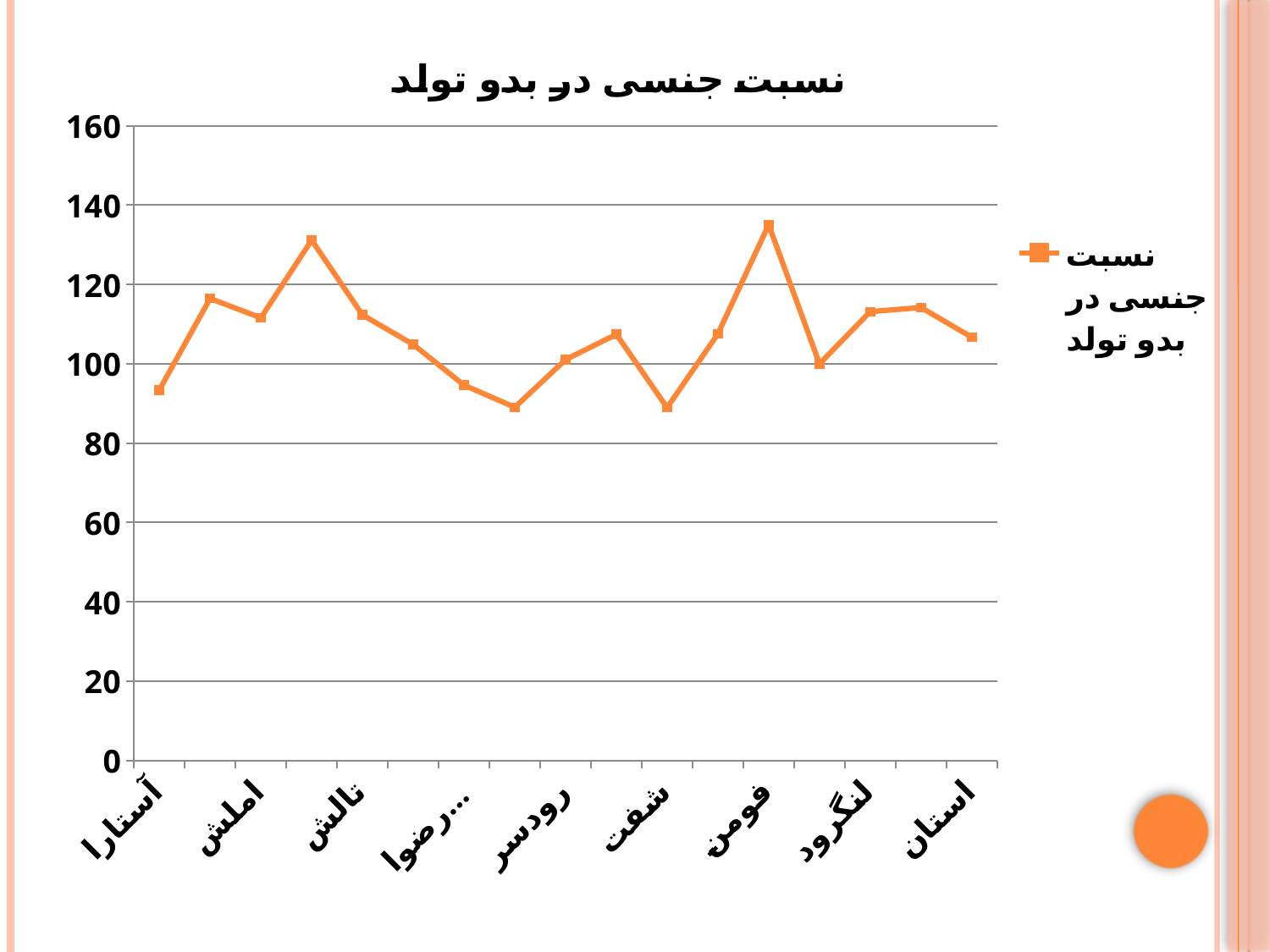
Which is larger, the value for تالش or the value for شفت? تالش Is the value for شفت greater or less than 100? less What is the title of the chart? نسبت جنسی در بدو تولد Is the value for آستارا greater or less than 100? less Is the value for استان greater or less than 120? less What kind of chart is shown on the slide? line chart Which labelled category has the highest value on the chart? فومن Does the line rise or fall between شفت and فومن? rise Which is larger, the value for فومن or the value for آستارا? فومن How many series does the legend list? 1